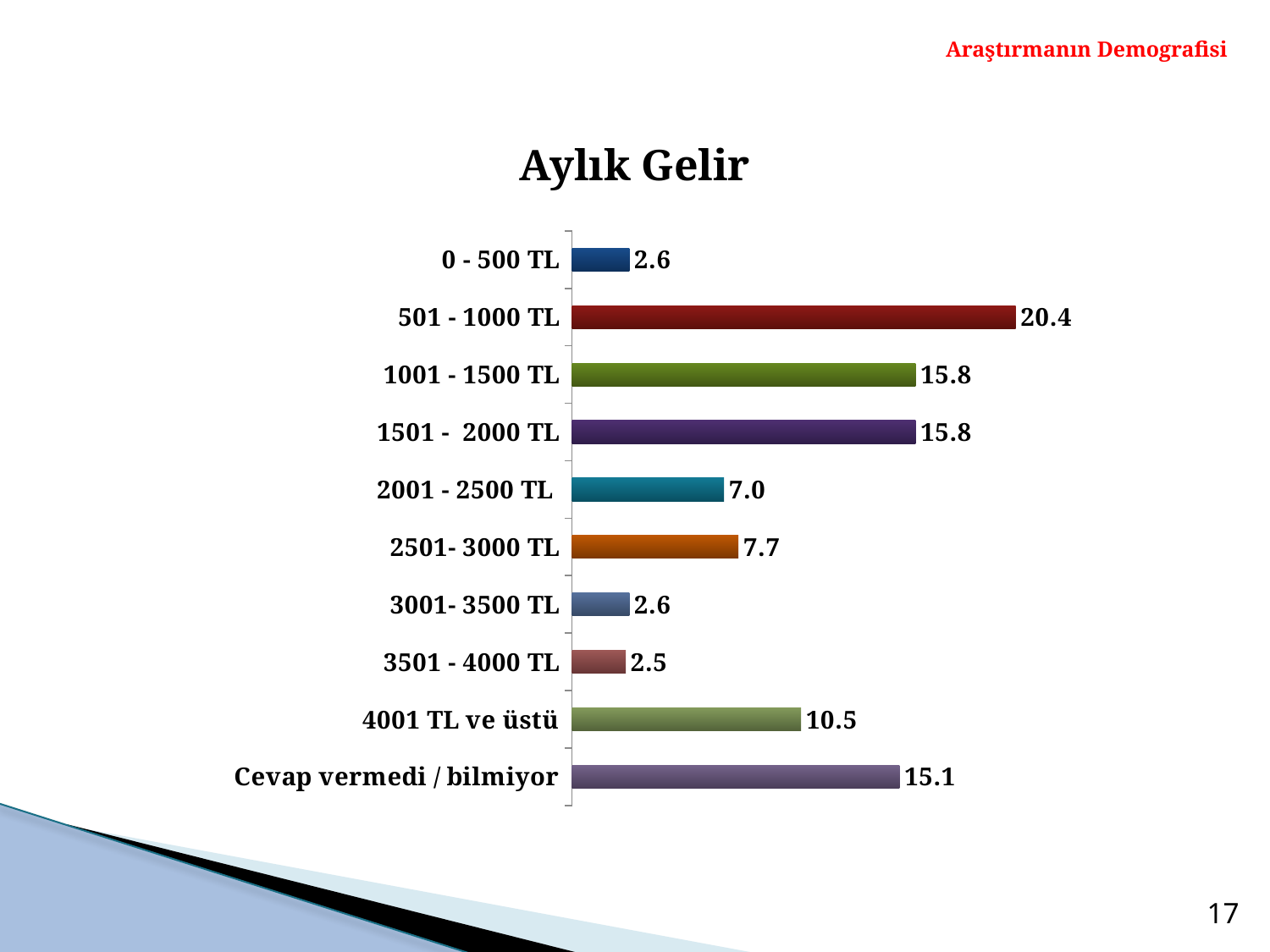
How many categories are shown in the chart? 10 What is the value for the Cevap vermedi / bilmiyor category? 15.1 What is the value for the 501 - 1000 TL category? 20.4 What is the difference between the values for 501 - 1000 TL and 1001 - 1500 TL? 4.6 Which category has the highest value? 501 - 1000 TL What is the difference between the values for 4001 TL ve üstü and 2001 - 2500 TL? 3.5 What is the value for the 4001 TL ve üstü category? 10.5 Which is larger, the value for 2501- 3000 TL or the value for 2001 - 2500 TL? 2501- 3000 TL Which category has the lowest value? 3501 - 4000 TL What is the value for the 2501- 3000 TL category? 7.7 What kind of chart is shown on the slide? Bar chart What is the title of the chart? Aylık Gelir